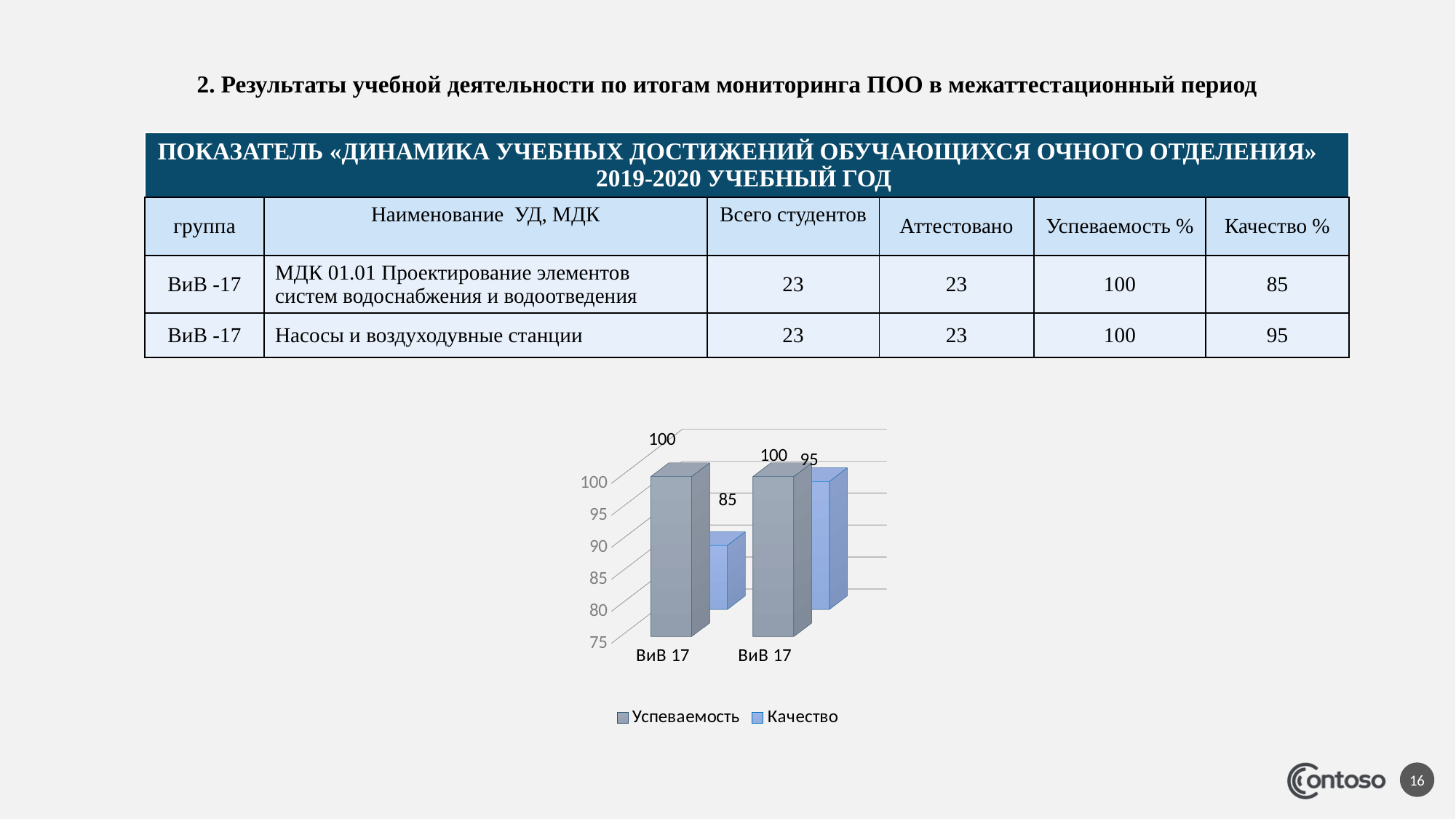
What is the difference between Успеваемость and Качество for the second (right) ВиВ 17 group in the chart? 5 How many series does the chart legend list? 2 What is the value of Качество for the first (left) ВиВ 17 group in the chart? 85 How many category groups are plotted along the x axis of the chart? 2 In the first (left) ВиВ 17 group, which series has the larger value, Успеваемость or Качество? Успеваемость What is the value of Успеваемость for the first (left) ВиВ 17 group in the chart? 100 What is the difference between the Качество values of the second and first ВиВ 17 groups in the chart? 10 What kind of chart is shown on the slide? bar chart What is the value of Качество for the second (right) ВиВ 17 group in the chart? 95 What are the two series named in the chart legend? Успеваемость and Качество Does the Качество value rise or fall from the first ВиВ 17 group to the second? rise Which group has the lower Качество value in the chart, the first (left) or the second (right) ВиВ 17 group? the first (left) ВиВ 17 group